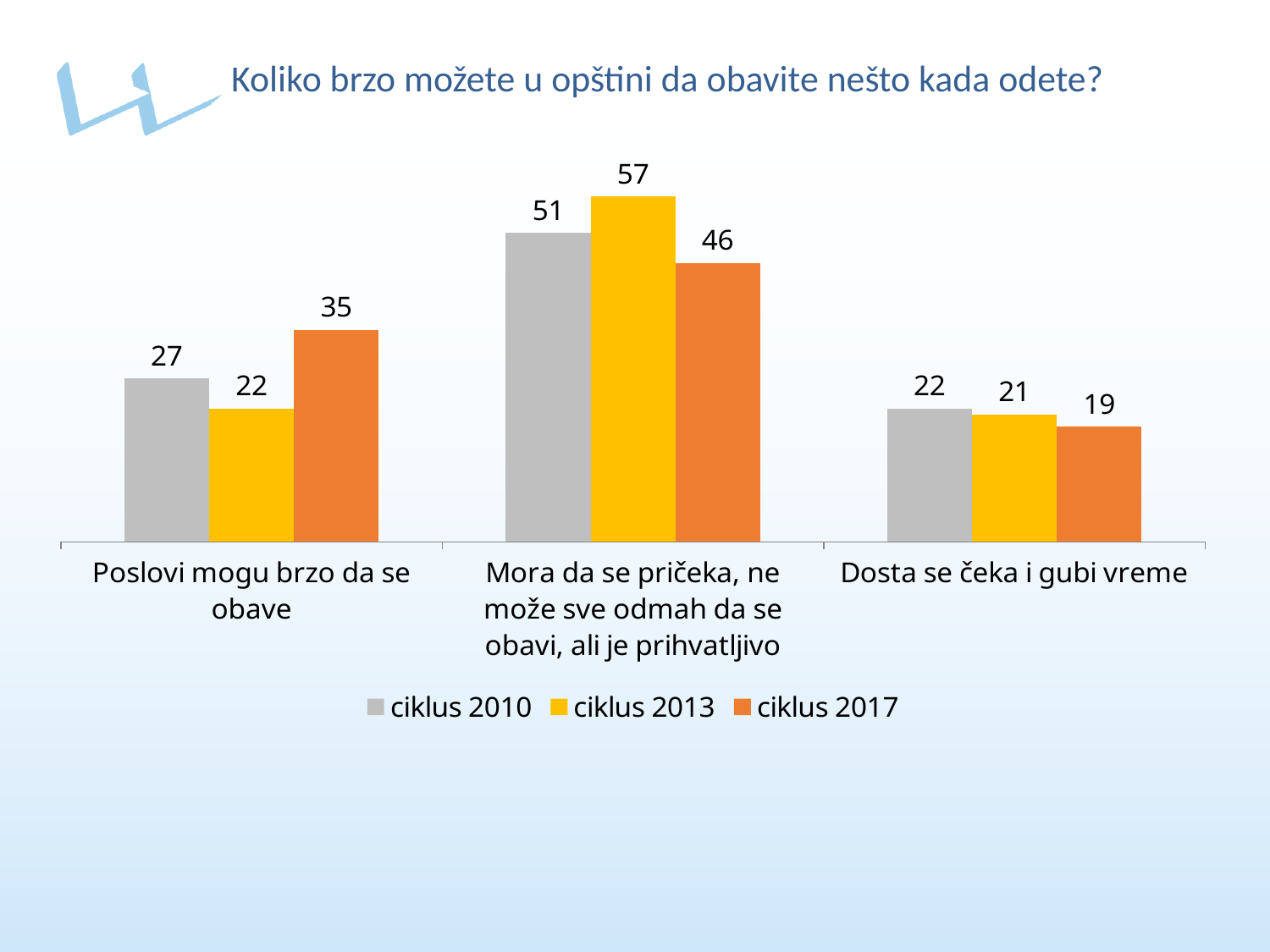
What is the difference between the ciklus 2013 and ciklus 2017 values for "Mora da se pričeka, ne može sve odmah da se obavi, ali je prihvatljivo"? 11 What is the difference between the ciklus 2017 and ciklus 2013 values for "Poslovi mogu brzo da se obave"? 13 What is the value for "Poslovi mogu brzo da se obave" in the ciklus 2017 series? 35 What kind of chart is shown on the slide? bar chart How many series does the legend list? 3 Which category has the highest value in the ciklus 2010 series? Mora da se pričeka, ne može sve odmah da se obavi, ali je prihvatljivo What is the value for "Mora da se pričeka, ne može sve odmah da se obavi, ali je prihvatljivo" in the ciklus 2013 series? 57 Which is larger for "Poslovi mogu brzo da se obave": the ciklus 2010 value or the ciklus 2017 value? ciklus 2017 Which category has the lowest value in the ciklus 2017 series? Dosta se čeka i gubi vreme Which series is shown in orange in the legend? ciklus 2017 What is the value for "Dosta se čeka i gubi vreme" in the ciklus 2010 series? 22 How many categories are shown on the x axis? 3